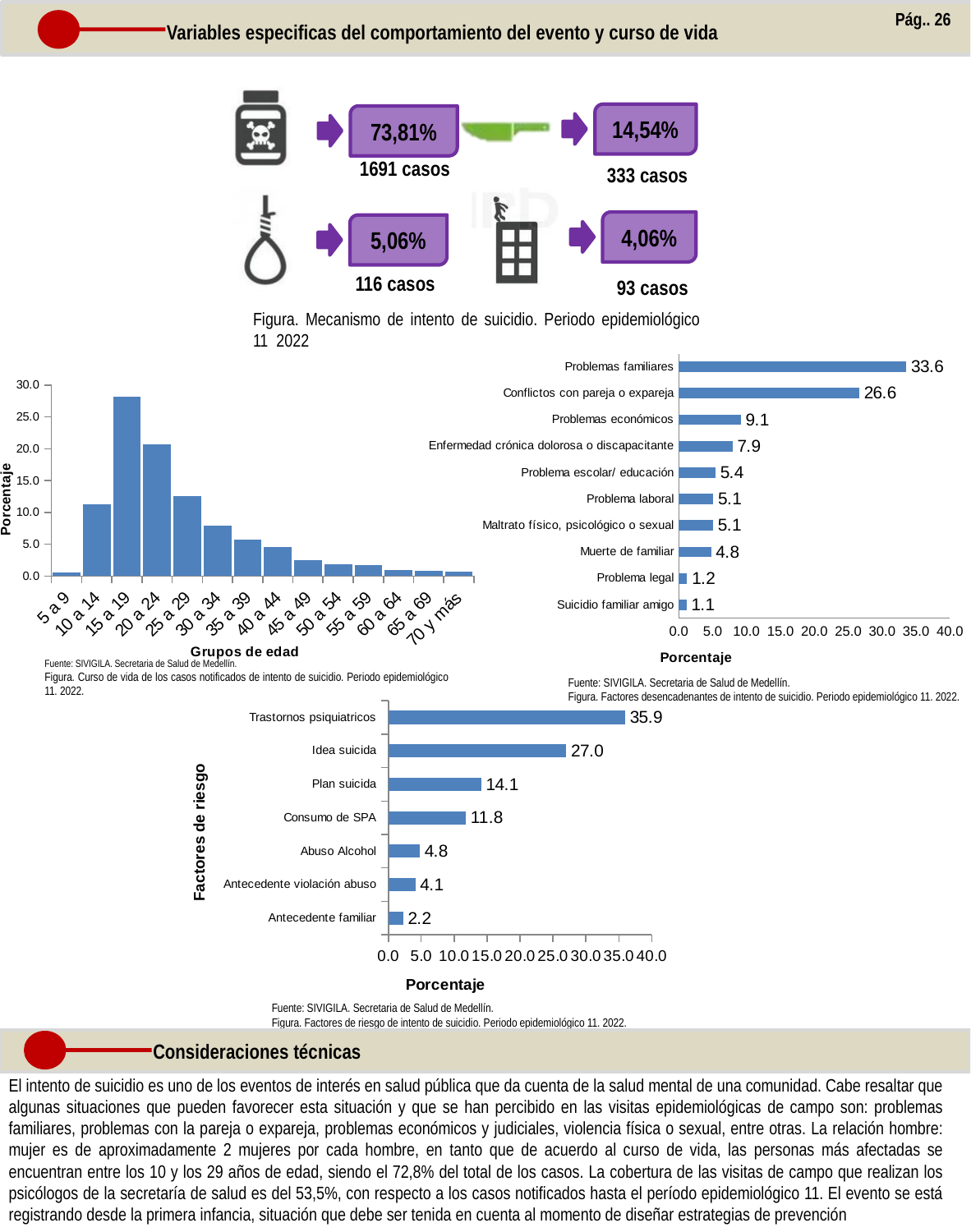
In the 'Factores de riesgo' chart (bottom), what is the value for Trastornos psiquiatricos? 35.9 In the 'Factores desencadenantes' chart (right), what is the value for Problemas familiares? 33.6 In the 'Factores desencadenantes' chart (right), what is the value for Conflictos con pareja o expareja? 26.6 In the 'Grupos de edad' chart (left), is the value for 20 a 24 greater or less than 15.0? greater In the 'Factores desencadenantes' chart (right), which category has the lowest value? Suicidio familiar amigo In the 'Factores de riesgo' chart (bottom), what is the difference between Idea suicida and Plan suicida? 12.9 In the 'Factores de riesgo' chart (bottom), which is larger: Plan suicida or Consumo de SPA? Plan suicida In the 'Grupos de edad' chart (left), which age group has the highest percentage? 15 a 19 In the 'Factores desencadenantes' chart (right), what is the difference between Problemas familiares and Problemas económicos? 24.5 In the 'Factores de riesgo' chart (bottom), what is the value for Consumo de SPA? 11.8 In the 'Factores desencadenantes' chart (right), how many categories are plotted? 10 In the 'Factores de riesgo' chart (bottom), which category has the highest value? Trastornos psiquiatricos